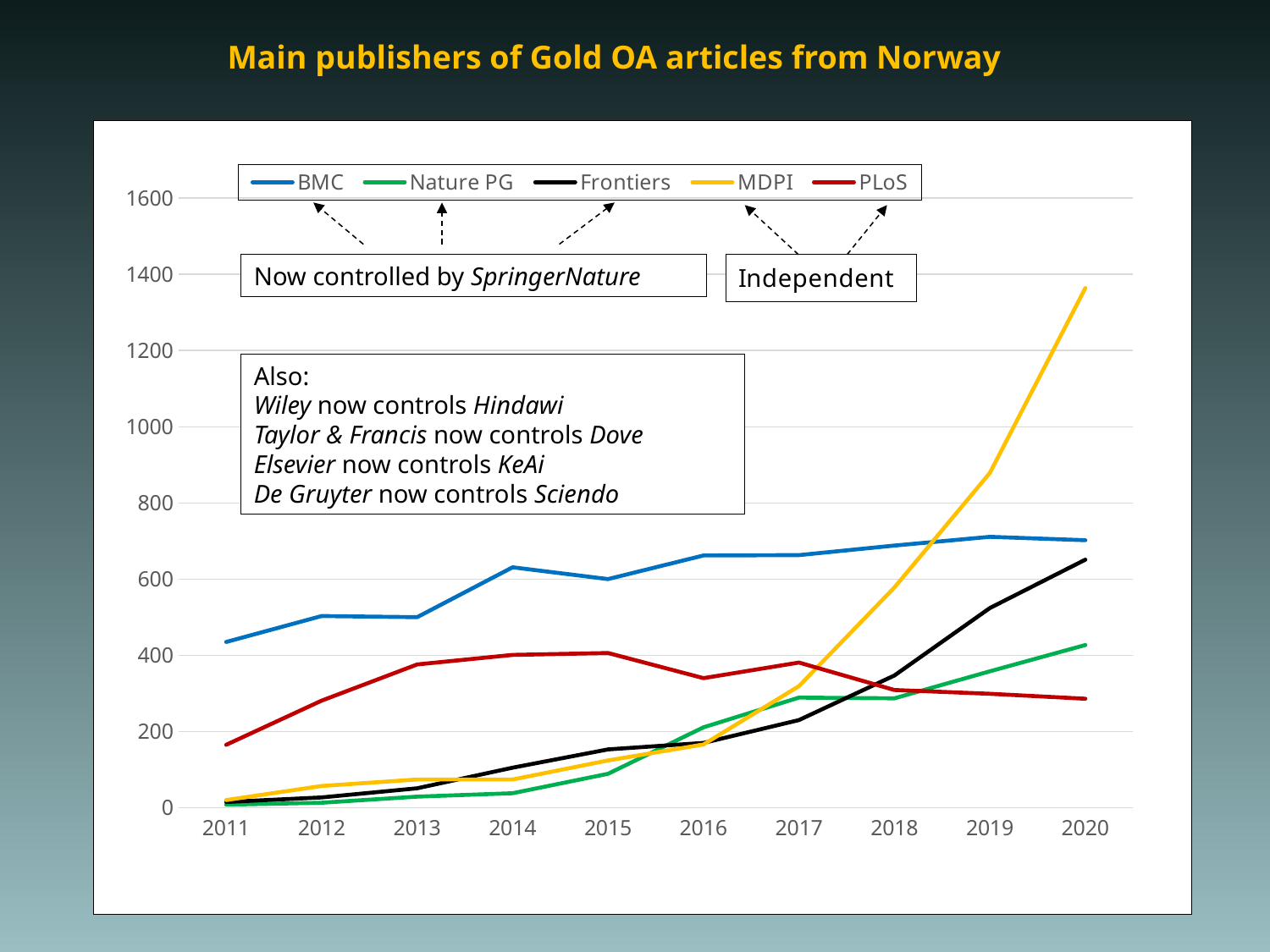
How many years are shown along the x axis? 10 What kind of chart is shown on the slide? line chart How many series does the legend list? 5 Is the value for MDPI in 2020 greater or less than 1200? greater Which publisher has the lowest value in 2020? PLoS Which publisher has the highest value in 2020? MDPI Which publisher has the highest value in 2011? BMC In 2020, which is larger: the value for Nature PG or the value for PLoS? Nature PG Is the value for PLoS in 2020 greater or less than 400? less Which publishers are marked as now controlled by SpringerNature? BMC, Nature PG, Frontiers Does the MDPI line rise or fall from 2011 to 2020? rise Is the value for BMC in 2019 greater or less than 600? greater